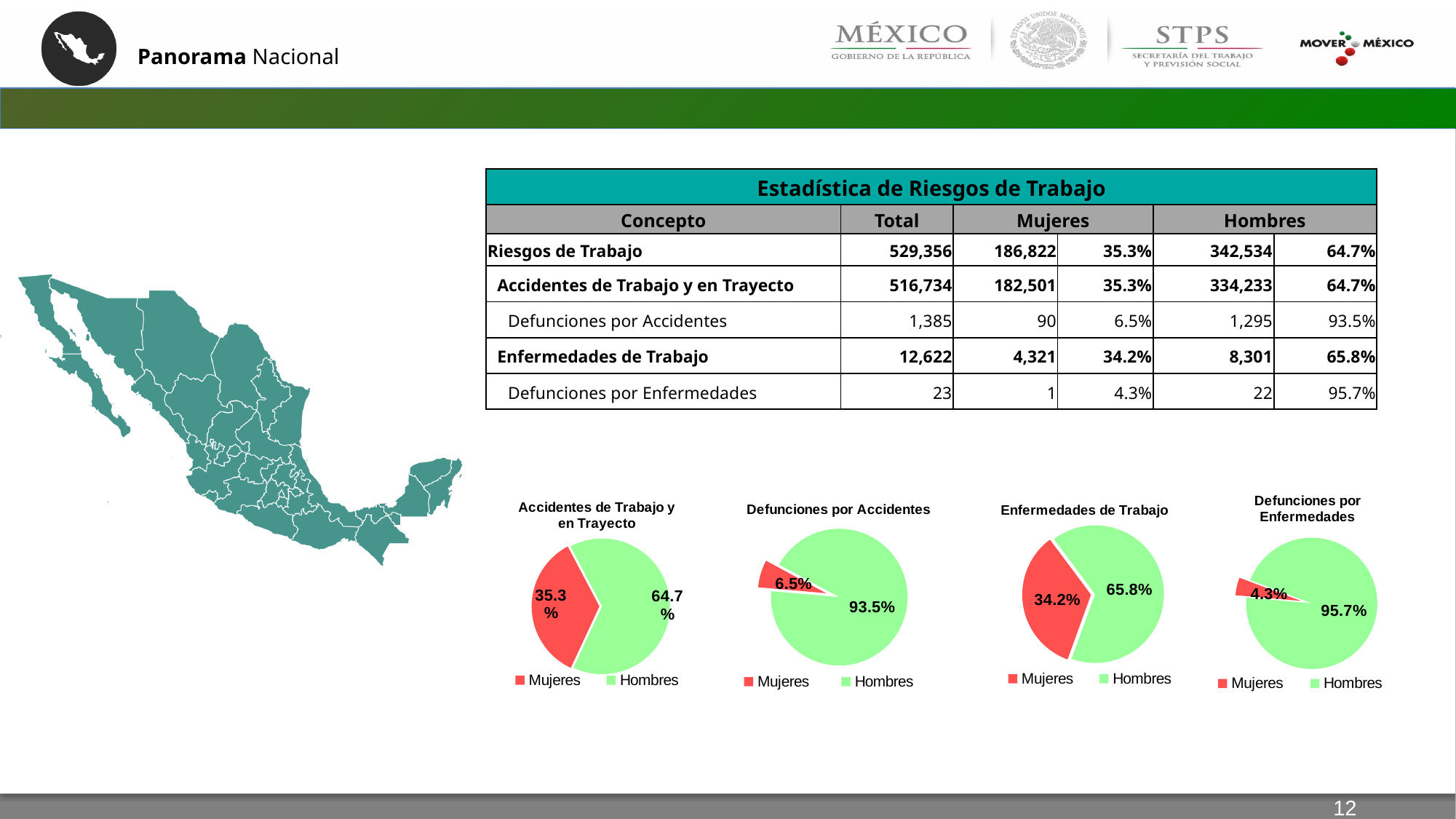
In the 'Defunciones por Enfermedades' pie chart, what share is labelled for Hombres? 95.7% In the 'Defunciones por Accidentes' pie chart, what is the difference between the Hombres and Mujeres shares? 87.0% In the 'Enfermedades de Trabajo' pie chart, what share is labelled for Mujeres? 34.2% In the 'Defunciones por Accidentes' pie chart, what share is labelled for Mujeres? 6.5% In the 'Defunciones por Enfermedades' pie chart, what colour is the Mujeres slice? Red How many entries does the legend of the 'Enfermedades de Trabajo' pie chart list? 2 What kind of chart is the 'Accidentes de Trabajo y en Trayecto' chart? Pie chart In the 'Defunciones por Enfermedades' pie chart, which slice is the smallest? Mujeres In the 'Enfermedades de Trabajo' pie chart, which slice is the largest? Hombres